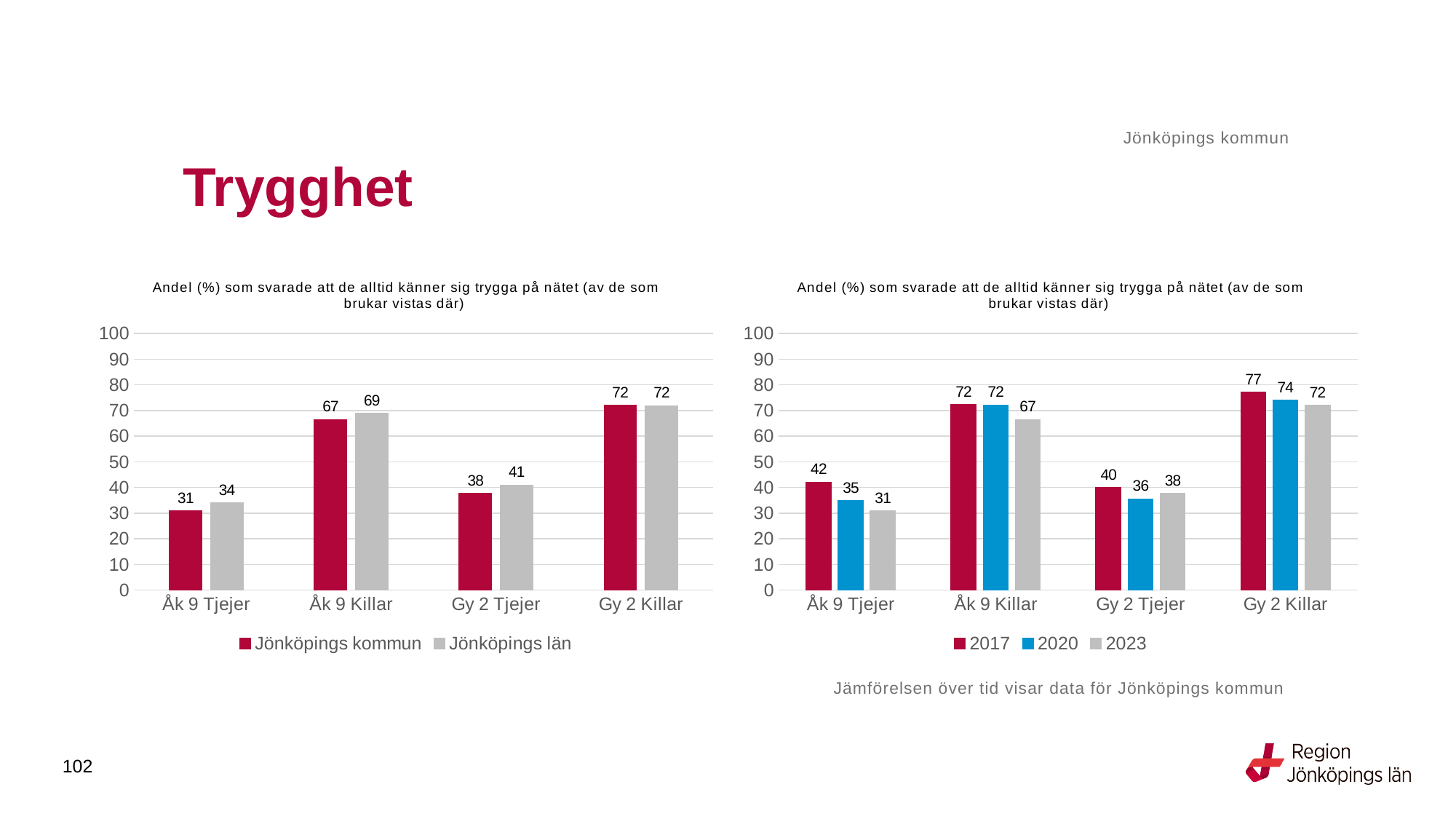
In the left chart, what is the value for Jönköpings kommun for Åk 9 Tjejer? 31 In the right chart, what is the value for 2017 for Gy 2 Killar? 77 In the left chart, what is the value for Jönköpings län for Gy 2 Tjejer? 41 In the right chart, which is larger for Åk 9 Tjejer: the 2017 value or the 2023 value? 2017 In the left chart, what is the difference between Jönköpings län and Jönköpings kommun for Åk 9 Killar? 2 In the left chart, which category has the lowest value for Jönköpings län? Åk 9 Tjejer In the right chart, how many categories are shown on the x axis? 4 In the left chart, how many series does the legend list? 2 In the left chart, which category has the highest value for Jönköpings kommun? Gy 2 Killar In the right chart, what is the difference between the 2017 and 2023 values for Åk 9 Tjejer? 11 In the right chart, what is the value for 2020 for Gy 2 Tjejer? 36 What kind of chart is the right chart? Bar chart